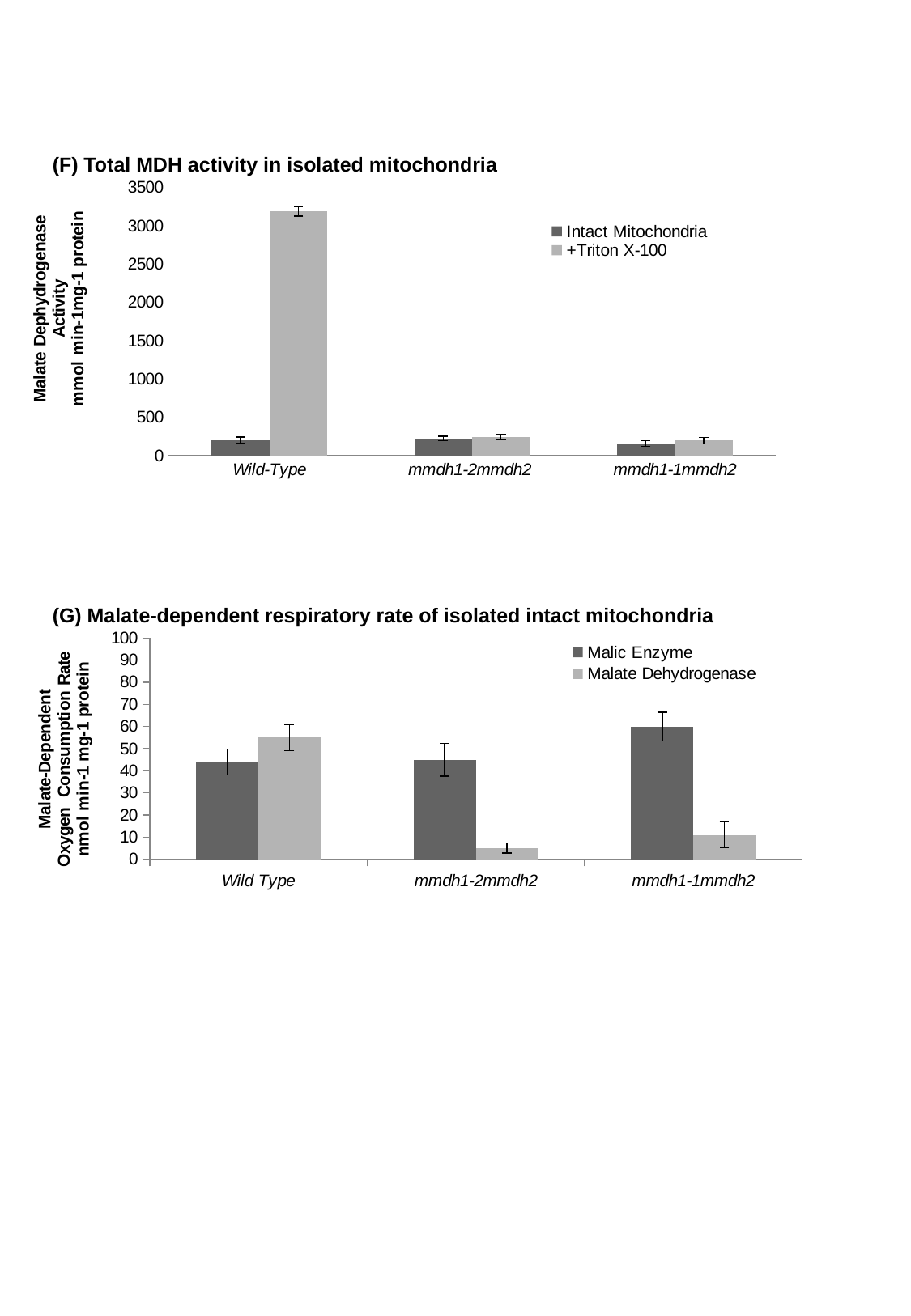
In the chart titled "(G) Malate-dependent respiratory rate of isolated intact mitochondria", is the Malate Dehydrogenase value for mmdh1-2mmdh2 greater or less than 10? less How many categories are shown on the x axis of the chart titled "(F) Total MDH activity in isolated mitochondria"? 3 What kind of chart is the chart titled "(G) Malate-dependent respiratory rate of isolated intact mitochondria"? Bar chart In the chart titled "(G) Malate-dependent respiratory rate of isolated intact mitochondria", which category has the highest Malic Enzyme value? mmdh1-1mmdh2 In the chart titled "(F) Total MDH activity in isolated mitochondria", for Wild-Type, which is larger: Intact Mitochondria or +Triton X-100? +Triton X-100 In the chart titled "(G) Malate-dependent respiratory rate of isolated intact mitochondria", for mmdh1-1mmdh2, which is larger: Malic Enzyme or Malate Dehydrogenase? Malic Enzyme What are the two legend entries in the chart titled "(G) Malate-dependent respiratory rate of isolated intact mitochondria"? Malic Enzyme and Malate Dehydrogenase How many series does the legend list in the chart titled "(F) Total MDH activity in isolated mitochondria"? 2 In the chart titled "(F) Total MDH activity in isolated mitochondria", is the +Triton X-100 value for Wild-Type greater or less than 3000? greater In the chart titled "(F) Total MDH activity in isolated mitochondria", which category and series has the highest bar? Wild-Type, +Triton X-100 In the chart titled "(G) Malate-dependent respiratory rate of isolated intact mitochondria", which category has the lowest Malate Dehydrogenase value? mmdh1-2mmdh2 In the chart titled "(F) Total MDH activity in isolated mitochondria", is the Intact Mitochondria value for mmdh1-2mmdh2 greater or less than 500? less